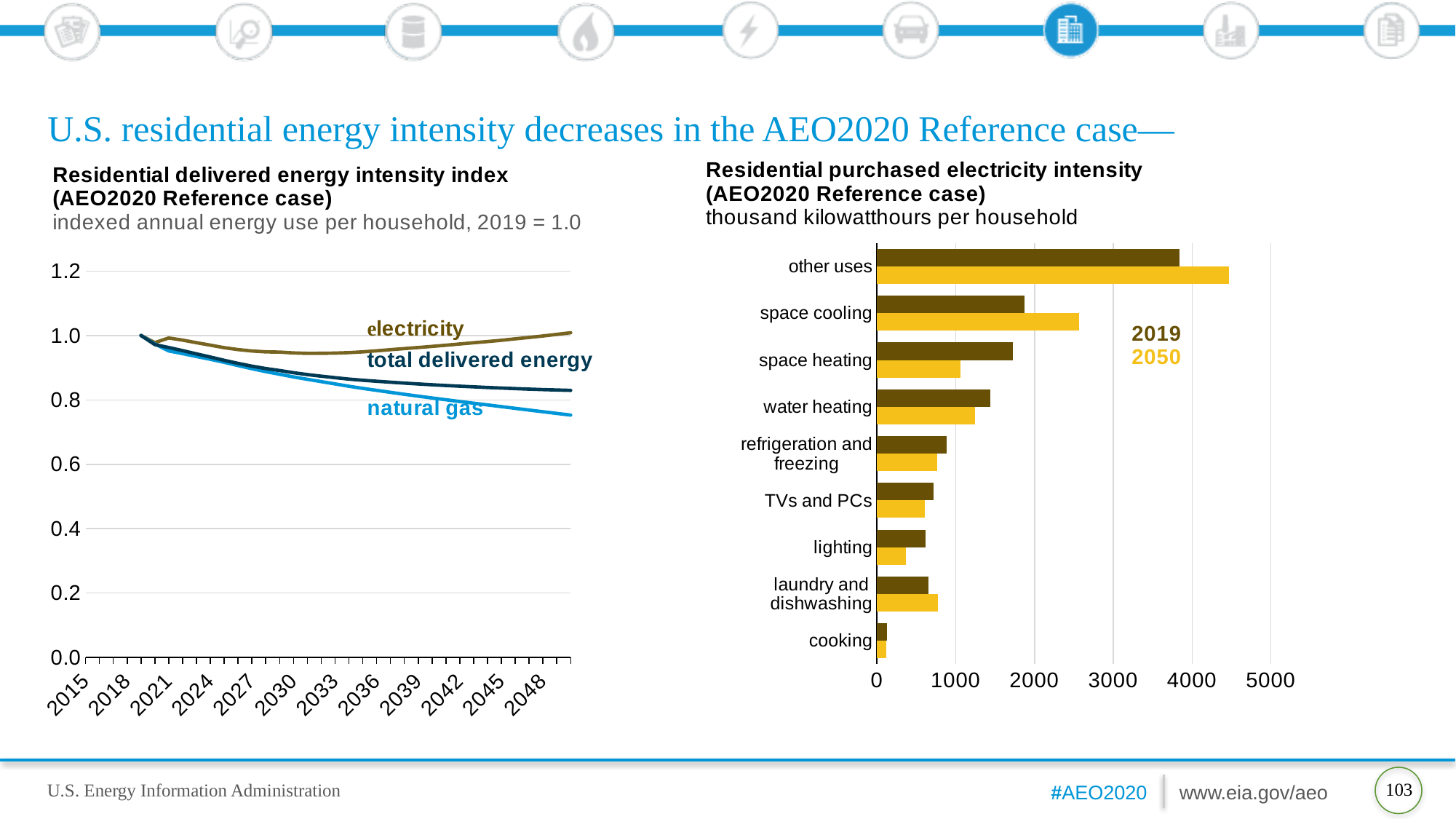
In the 'Residential delivered energy intensity index' chart, does the natural gas line rise or fall from 2019 to 2050? fall In the 'Residential purchased electricity intensity' chart, is space heating larger in 2019 or in 2050? 2019 In the 'Residential purchased electricity intensity' chart, which category has the lowest value in 2019? cooking In the 'Residential purchased electricity intensity' chart, which two years does the legend list? 2019 and 2050 In the 'Residential purchased electricity intensity' chart, which category has the highest value in 2050? other uses In the 'Residential purchased electricity intensity' chart, how many end-use categories are shown? 9 What kind of chart is the 'Residential delivered energy intensity index' chart on the left? line chart What kind of chart is the 'Residential purchased electricity intensity' chart on the right? bar chart In the 'Residential purchased electricity intensity' chart, is the 2050 value for other uses greater or less than 4000? greater In the 'Residential delivered energy intensity index' chart, which series has the highest value in 2050? electricity In the 'Residential delivered energy intensity index' chart, how many series are plotted? 3 In the 'Residential delivered energy intensity index' chart, which series has the lowest value in 2050? natural gas